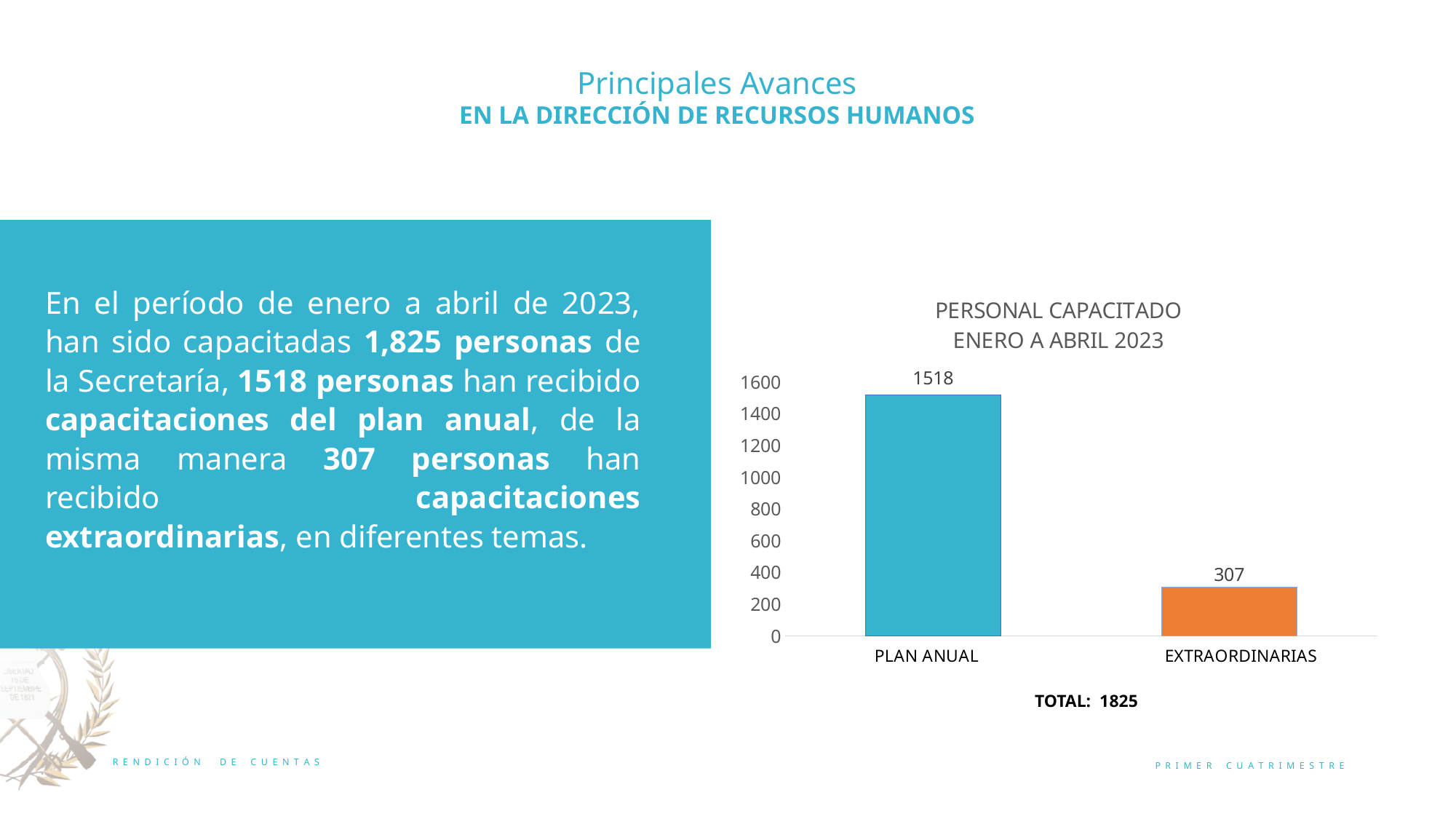
How many categories are shown in the chart? 2 What is the difference between the PLAN ANUAL and EXTRAORDINARIAS values? 1211 What is the value for PLAN ANUAL in the chart? 1518 Which is larger, the value for PLAN ANUAL or for EXTRAORDINARIAS? PLAN ANUAL What is the value for EXTRAORDINARIAS in the chart? 307 What is the title of the chart? PERSONAL CAPACITADO ENERO A ABRIL 2023 Is the value for PLAN ANUAL greater or less than 1400? greater What kind of chart is shown on the slide? bar chart What is the total of the two values shown in the chart? 1825 Which category has the lowest value in the chart? EXTRAORDINARIAS Is the value for EXTRAORDINARIAS greater or less than 400? less Which category has the highest value in the chart? PLAN ANUAL